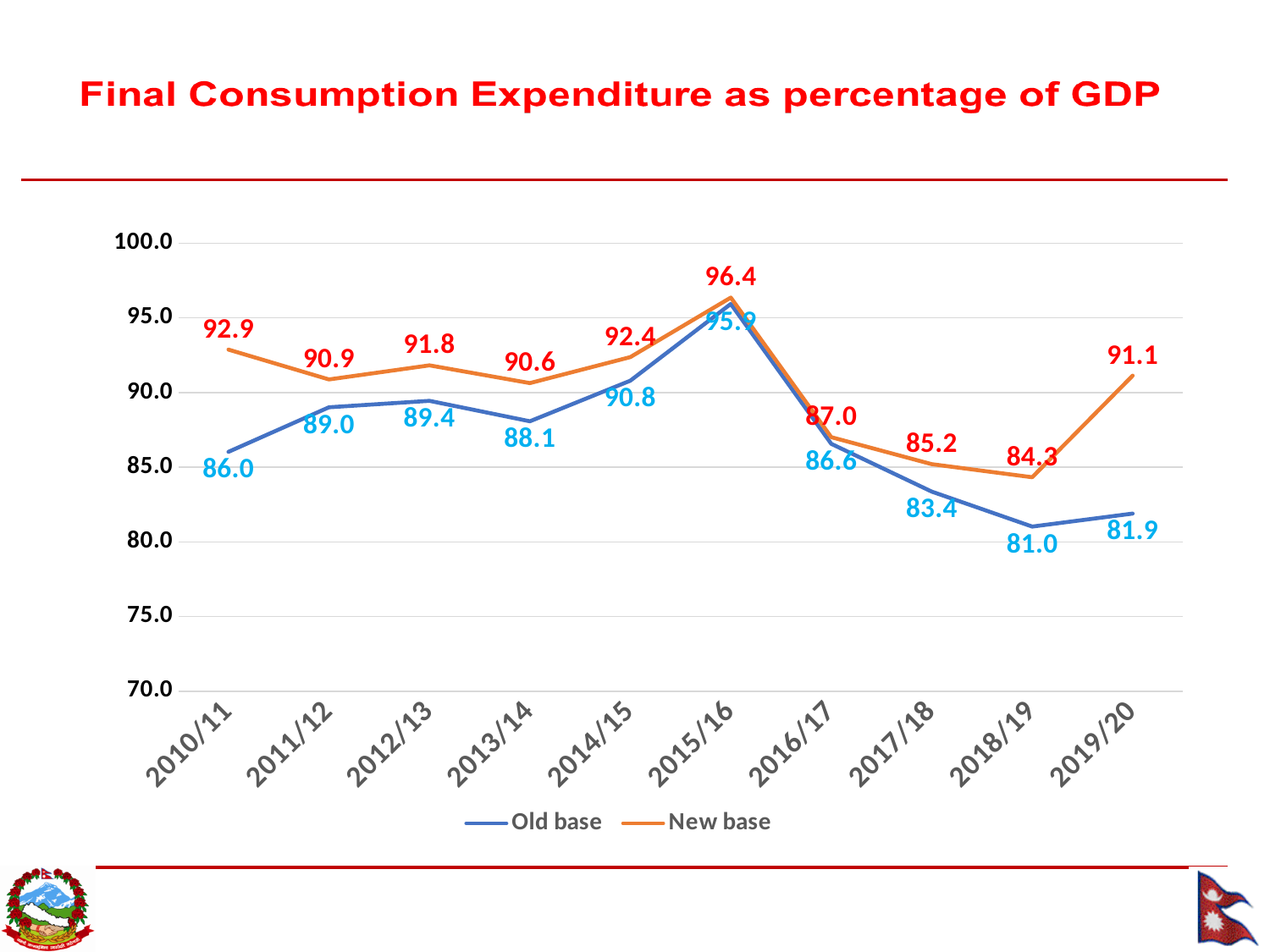
What is the difference between the New base and Old base values in 2010/11? 6.9 How many fiscal years are shown on the x axis? 10 What kind of chart is shown on the slide? line chart In which year does the New base series reach its highest value? 2015/16 In 2017/18, which series has the higher value, Old base or New base? New base How many series does the legend list? 2 What is the New base value for 2019/20? 91.1 In which year is the Old base value lowest? 2018/19 Does the Old base series rise or fall from 2016/17 to 2018/19? fall Is the Old base value for 2019/20 greater or less than 85.0? less What is the difference between the New base and Old base values in 2019/20? 9.2 What is the Old base value for 2018/19? 81.0